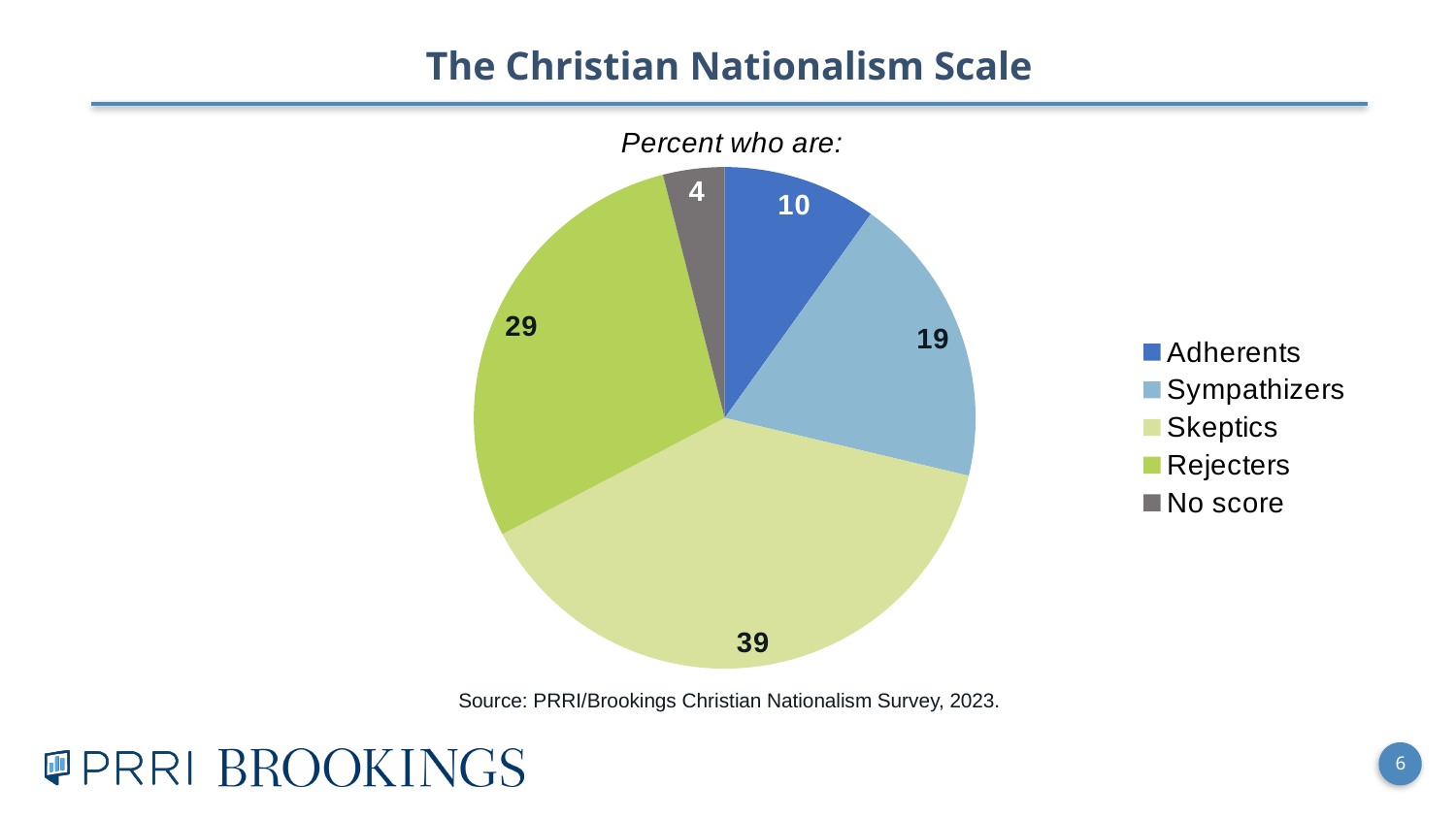
Which is larger, the value for Sympathizers or the value for Adherents? Sympathizers What percent have No score? 4 How many categories does the legend list? 5 What kind of chart is shown on the slide? Pie chart What percent are Rejecters? 29 What percent are Skeptics? 39 What is the title of the chart? The Christian Nationalism Scale What percent are Adherents? 10 Which category has the smallest share of the pie? No score What percent are Sympathizers? 19 Which category has the largest share of the pie? Skeptics What is the difference between the Skeptics and Rejecters values? 10